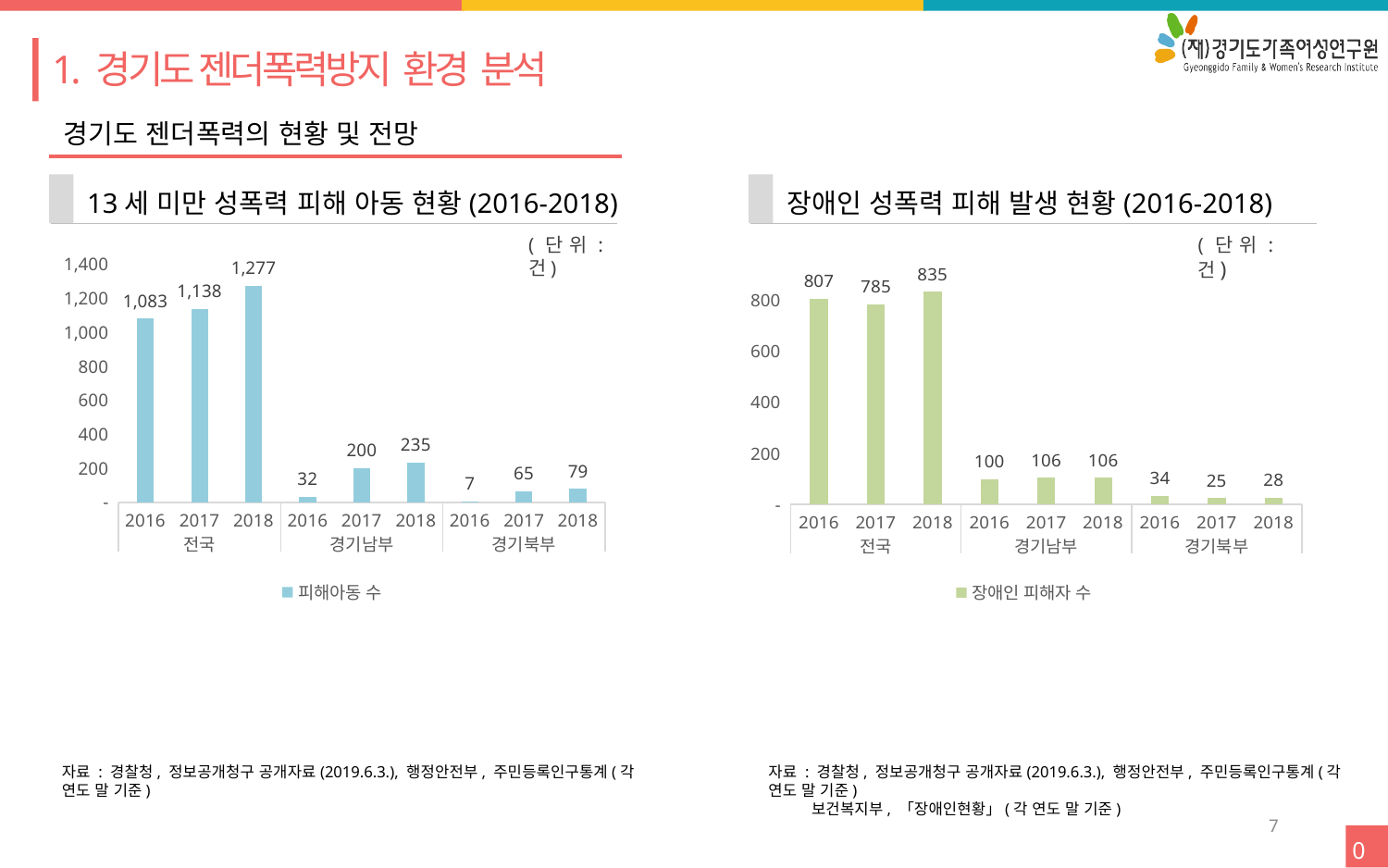
In the left chart (13세 미만 성폭력 피해 아동 현황), do the 경기북부 values rise or fall from 2016 to 2018? rise In the left chart (13세 미만 성폭력 피해 아동 현황), what is the difference between the 전국 values for 2018 and 2016? 194 In the left chart (13세 미만 성폭력 피해 아동 현황), what is the value for 전국 in 2018? 1,277 In the right chart (장애인 성폭력 피해 발생 현황), which is larger: 경기남부 2016 or 경기북부 2016? 경기남부 2016 In the right chart (장애인 성폭력 피해 발생 현황), what is the value for 전국 in 2017? 785 In the left chart (13세 미만 성폭력 피해 아동 현황), which bar has the lowest value? 경기북부 2016 What type of chart is the right chart (장애인 성폭력 피해 발생 현황)? bar chart In the left chart (13세 미만 성폭력 피해 아동 현황), how many bars are plotted? 9 In the right chart (장애인 성폭력 피해 발생 현황), what is the value for 경기북부 in 2016? 34 In the left chart (13세 미만 성폭력 피해 아동 현황), what is the value for 경기남부 in 2017? 200 In the right chart (장애인 성폭력 피해 발생 현황), what is the difference between the 전국 values for 2018 and 2017? 50 In the right chart (장애인 성폭력 피해 발생 현황), which bar has the highest value? 전국 2018